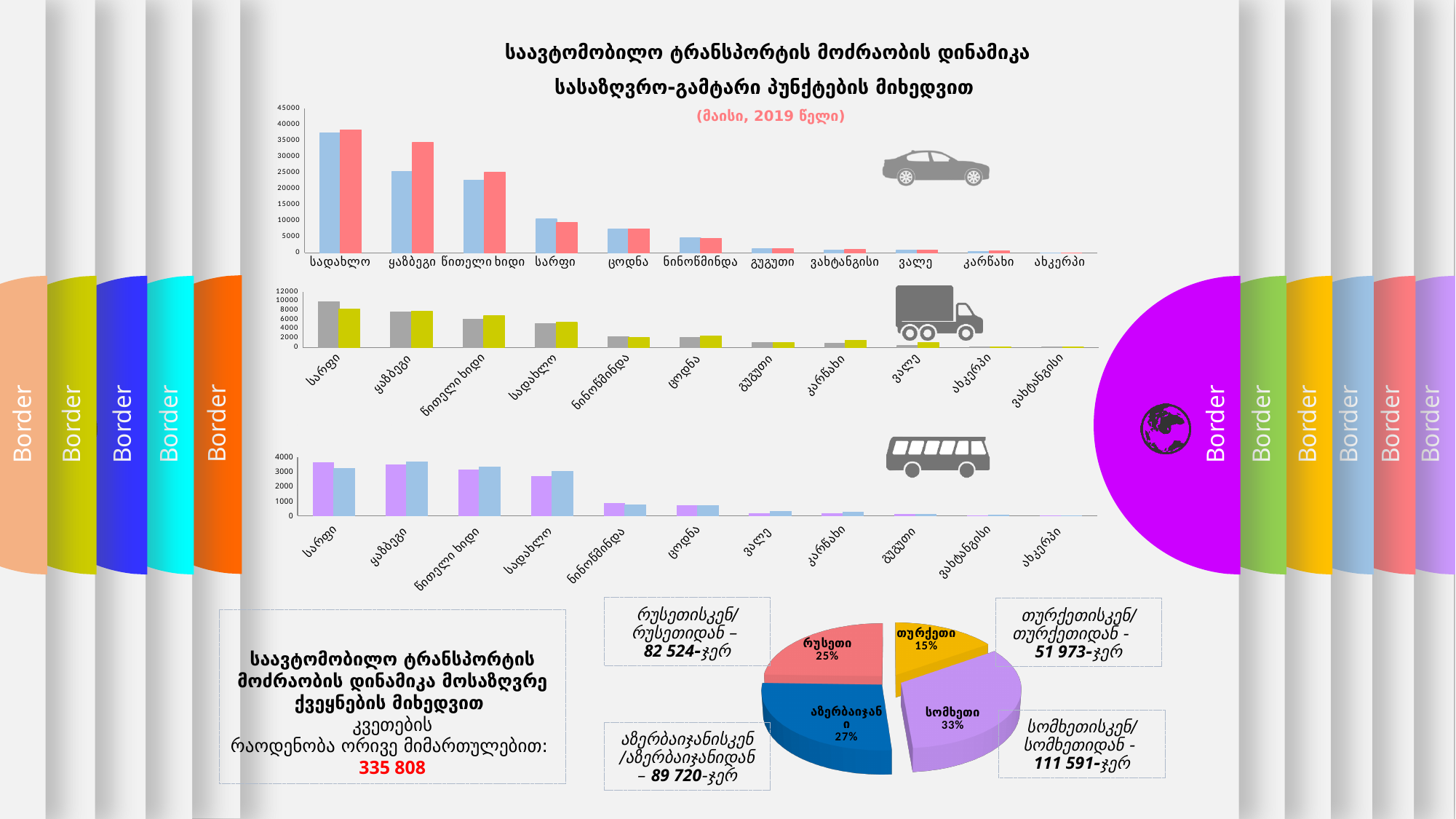
How many categories are shown on the x axis of the top chart (with the car icon)? 11 How many slices does the pie chart at the bottom of the slide have? 4 In the pie chart at the bottom of the slide, which country has the smallest slice? თურქეთი In the middle chart with the truck icon, which category has the highest values? სარფი In the pie chart at the bottom of the slide, which is larger, the share for აზერბაიჯანი or the share for რუსეთი? აზერბაიჯანი What kind of chart is the chart at the bottom of the slide showing countries? pie chart In the pie chart at the bottom of the slide, which country has the largest slice? სომხეთი What kind of chart is the top chart with the car icon? bar chart In the bottom bar chart with the bus icon, do the values rise or fall from left to right along the x axis? fall In the pie chart at the bottom of the slide, what share does სომხეთი have? 33% In the top chart with the car icon, which category has the highest values? სადახლო In the pie chart at the bottom of the slide, what is the difference in percentage points between სომხეთი and რუსეთი? 8%